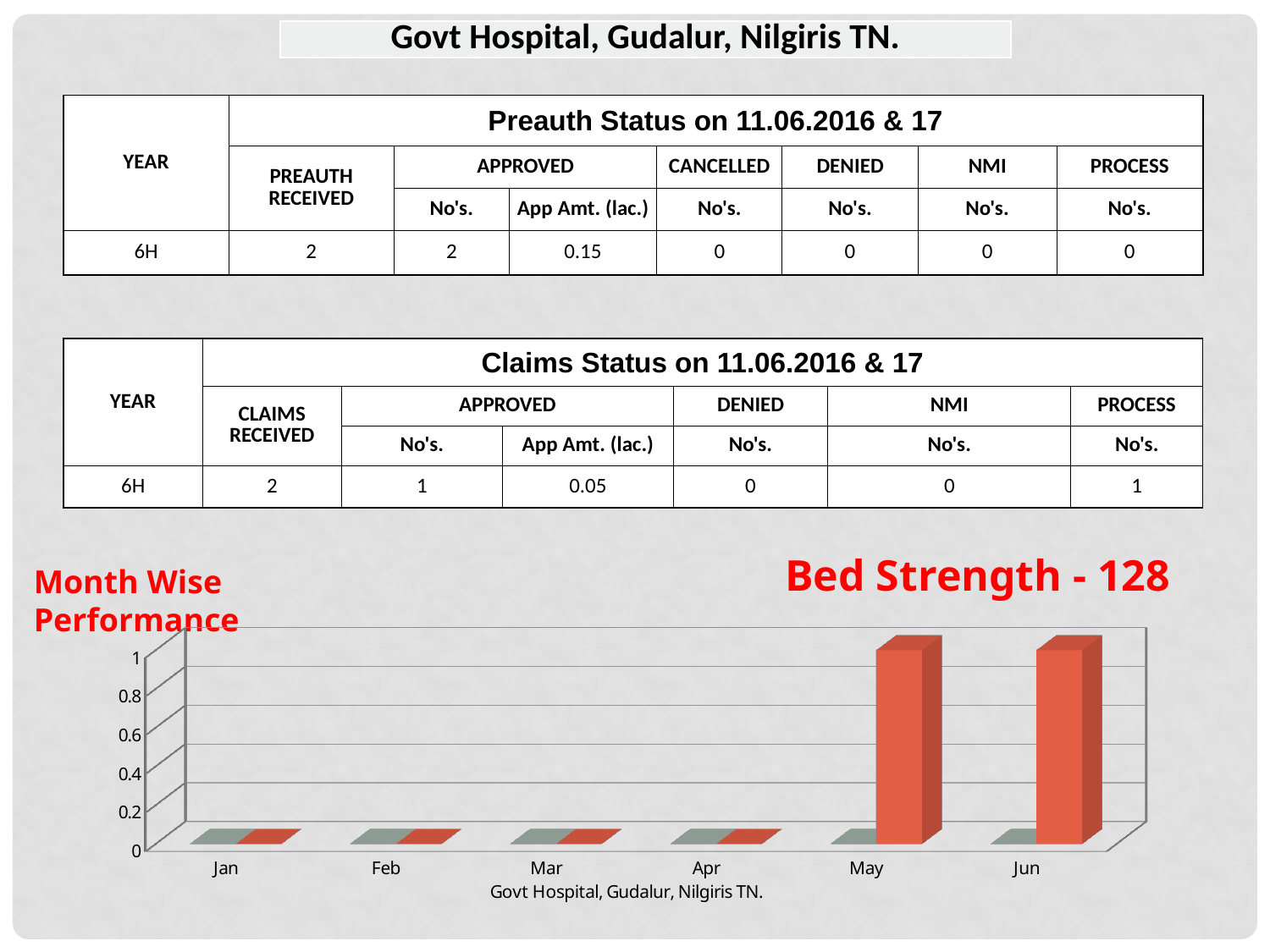
In the Month Wise Performance chart, is the orange bar for May greater or less than 0.6? greater In the Month Wise Performance chart, is the orange bar for Jan greater or less than 0.2? less In the Month Wise Performance chart, do the orange bars rise or fall from Apr to May? rise In the Month Wise Performance chart, which is larger, the orange bar for Apr or the orange bar for May? May In the Month Wise Performance chart, is the orange bar for Jun greater or less than 0.8? greater What is the highest value labelled on the y axis of the Month Wise Performance chart? 1 How many months are shown on the x axis of the Month Wise Performance chart? 6 What text appears below the x axis of the Month Wise Performance chart? Govt Hospital, Gudalur, Nilgiris TN. In the Month Wise Performance chart, which months have the tallest orange bars? May and Jun What kind of chart is shown at the bottom of the slide? bar chart In the Month Wise Performance chart, what value does the orange bar for May reach? 1